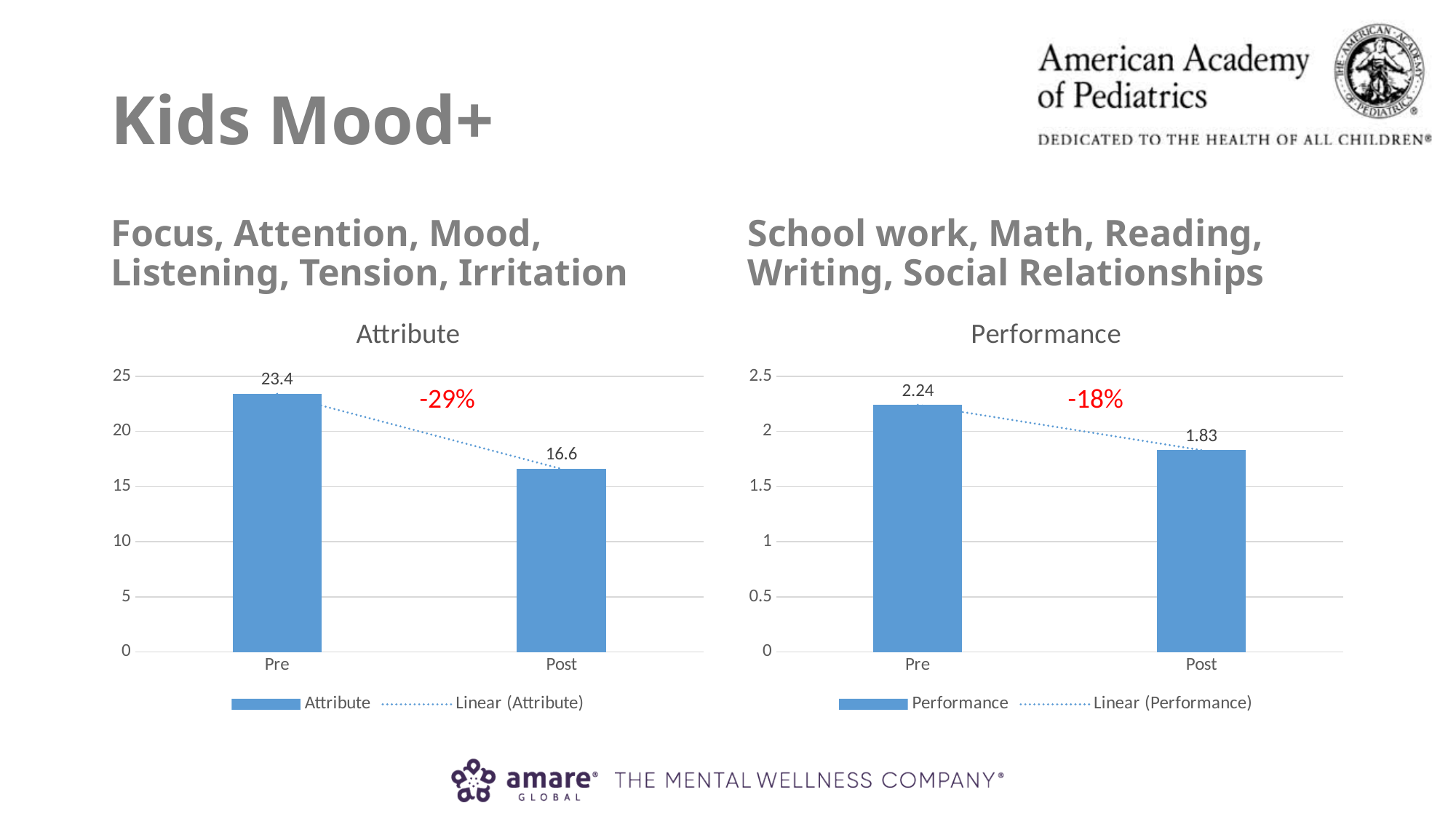
In the Attribute chart, what is the value for Post? 16.6 What kind of chart is the Performance chart? bar chart How many categories are shown on the x axis of the Attribute chart? 2 What percentage change is annotated in red on the Performance chart? -18% In the Performance chart, which category has the lowest value? Post In the Performance chart, what is the value for Pre? 2.24 In the Attribute chart, what is the value for Pre? 23.4 In the Attribute chart, which category has the higher value, Pre or Post? Pre In the Attribute chart, what is the difference between the Pre and Post values? 6.8 In the Performance chart, what is the difference between the Pre and Post values? 0.41 In the Performance chart, what is the value for Post? 1.83 In the Attribute chart, do the values rise or fall from Pre to Post? fall